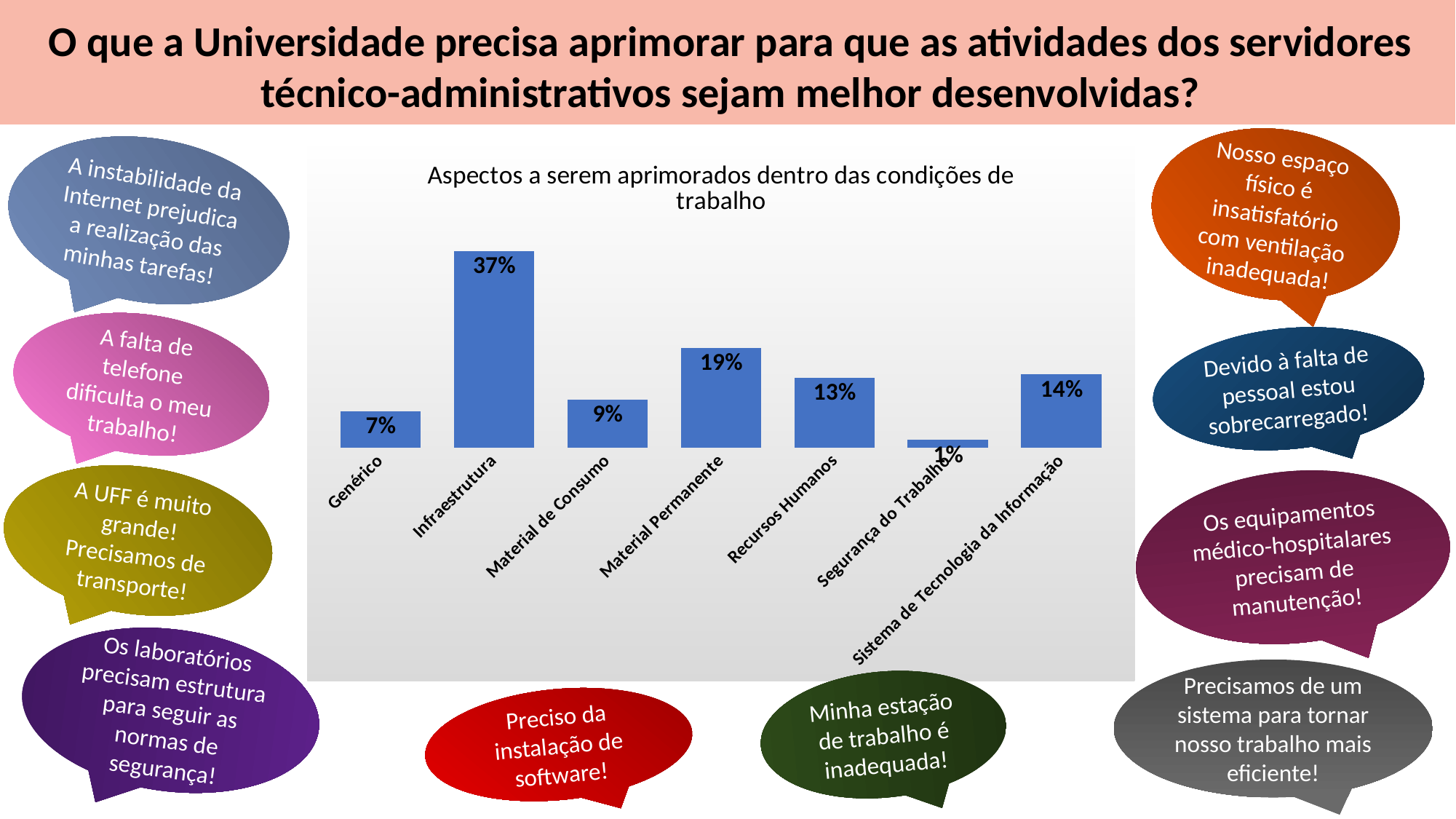
What value is shown for Material Permanente? 19% What value is shown for Infraestrutura? 37% What is the difference between the values for Infraestrutura and Material Permanente? 18% What is the title of the chart? Aspectos a serem aprimorados dentro das condições de trabalho Which category has the highest value? Infraestrutura Which is larger, the value for Recursos Humanos or the value for Material de Consumo? Recursos Humanos What kind of chart is shown on the slide? Bar chart How many categories are shown in the chart? 7 What value is shown for Recursos Humanos? 13% Which category has the lowest value? Segurança do Trabalho What value is shown for Sistema de Tecnologia da Informação? 14% What is the difference between the values for Material de Consumo and Genérico? 2%